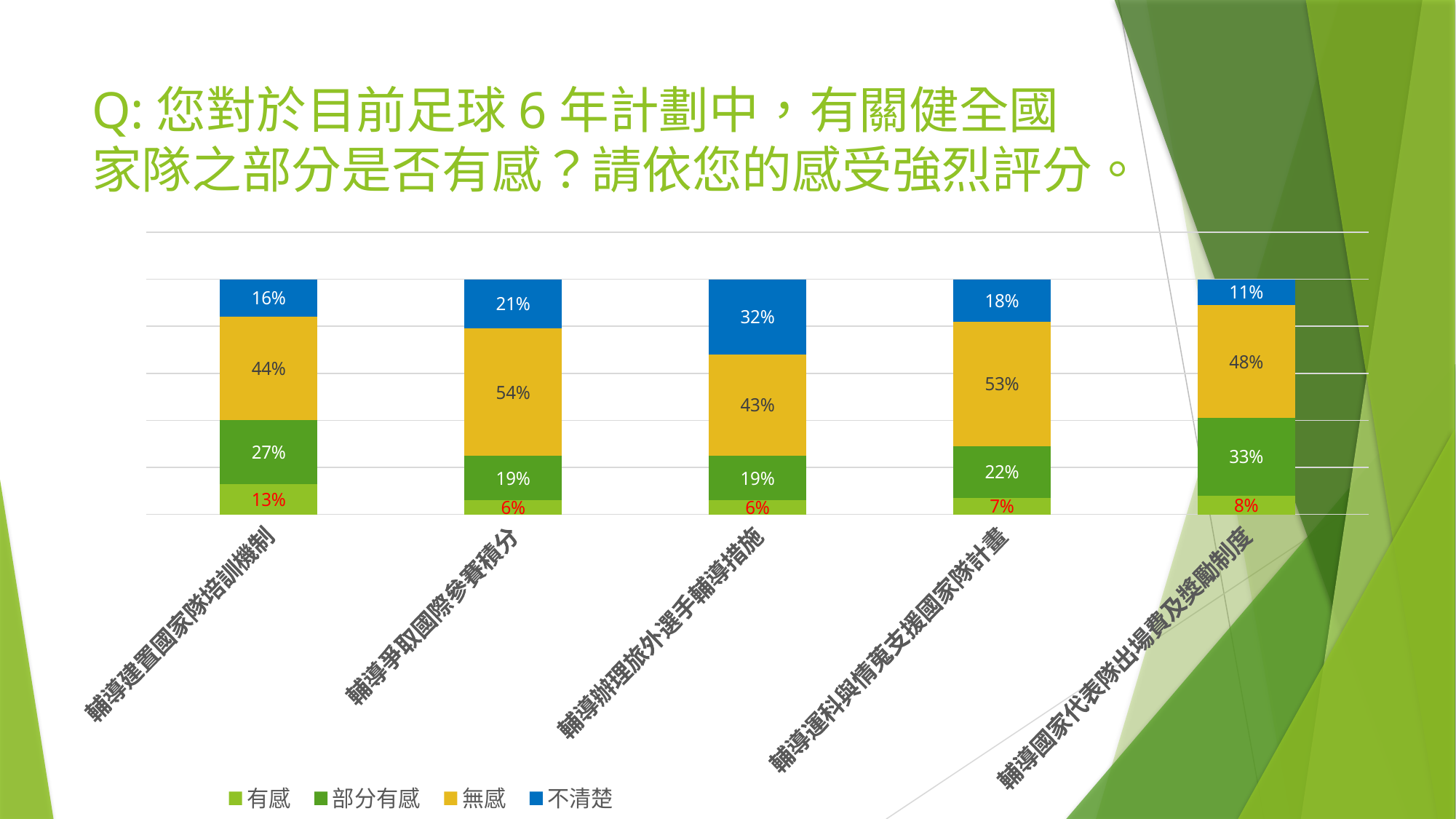
Which category has the lowest 不清楚 value? 輔導國家代表隊出場費及獎勵制度 What is the 無感 value for 輔導爭取國際參賽積分? 54% What is the 部分有感 value for 輔導國家代表隊出場費及獎勵制度? 33% What is the 有感 value for 輔導建置國家隊培訓機制? 13% Which legend entry is shown in blue? 不清楚 How many categories are plotted on the x axis? 5 Which category has the highest 有感 value? 輔導建置國家隊培訓機制 How many series does the legend list? 4 What kind of chart is shown on the slide? Stacked bar chart What is the 不清楚 value for 輔導辦理旅外選手輔導措施? 32% Which is larger: the 部分有感 value for 輔導運科與情蒐支援國家隊計畫 or for 輔導建置國家隊培訓機制? 輔導建置國家隊培訓機制 What is the difference between the 無感 values for 輔導爭取國際參賽積分 and 輔導辦理旅外選手輔導措施? 11%